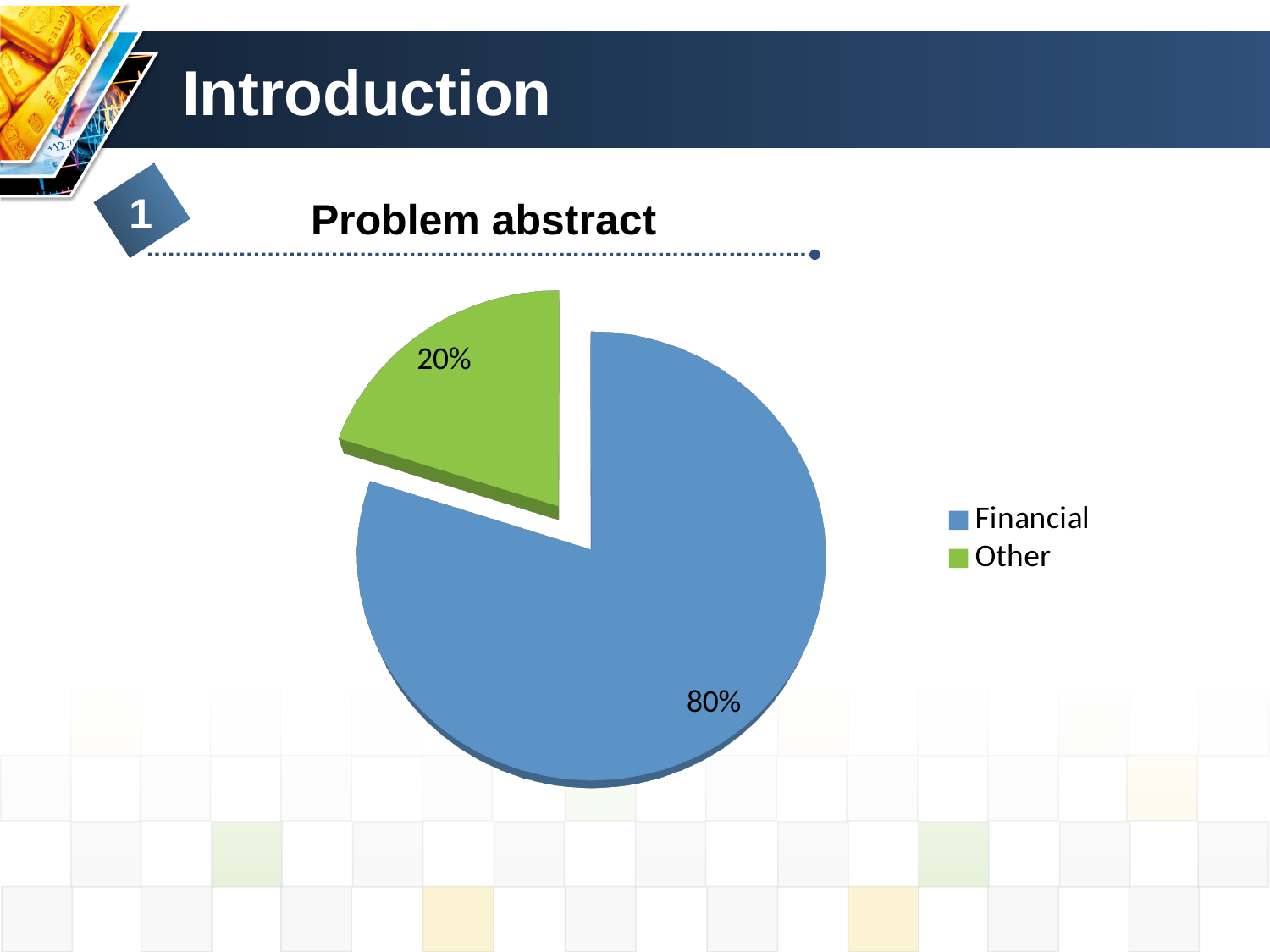
How many slices does the pie chart have? 2 Which slice of the pie is the largest? Financial How many entries does the legend list? 2 Which is larger, the Financial slice or the Other slice? Financial What colour is the Other slice in the pie chart? Green Which slice of the pie is the smallest? Other What is the difference in percentage points between the Financial and Other slices? 60 percentage points What share of the pie does the Other slice represent? 20% What kind of chart is shown on the slide? Pie chart What colour is the Financial slice in the pie chart? Blue What share of the pie does the Financial slice represent? 80% Is the share of the Financial slice greater or less than 50%? greater